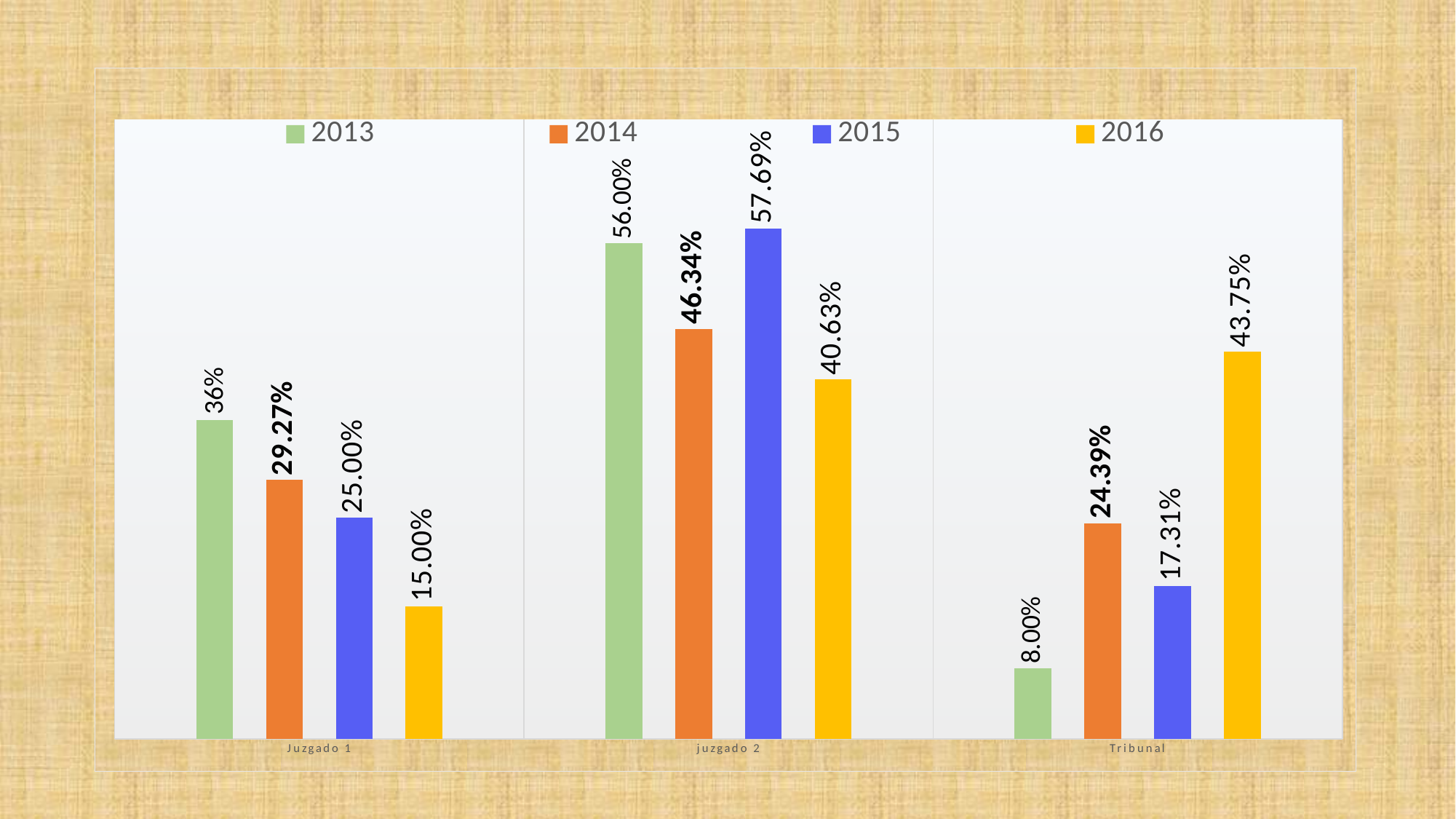
What is the difference between the 2013 and 2016 values in Juzgado 1? 21.00% How many series does the legend list? 4 Which series is shown in yellow in the legend? 2016 Which category has the highest value for 2016? Tribunal Which is larger in juzgado 2, the 2013 value or the 2014 value? 2013 What kind of chart is shown on the slide? Bar chart How many categories are shown on the x axis? 3 What is the value for 2013 in Juzgado 1? 36% What is the value for 2016 in Tribunal? 43.75% What is the value for 2015 in juzgado 2? 57.69% Which category has the lowest value for 2013? Tribunal What is the value for 2014 in Tribunal? 24.39%